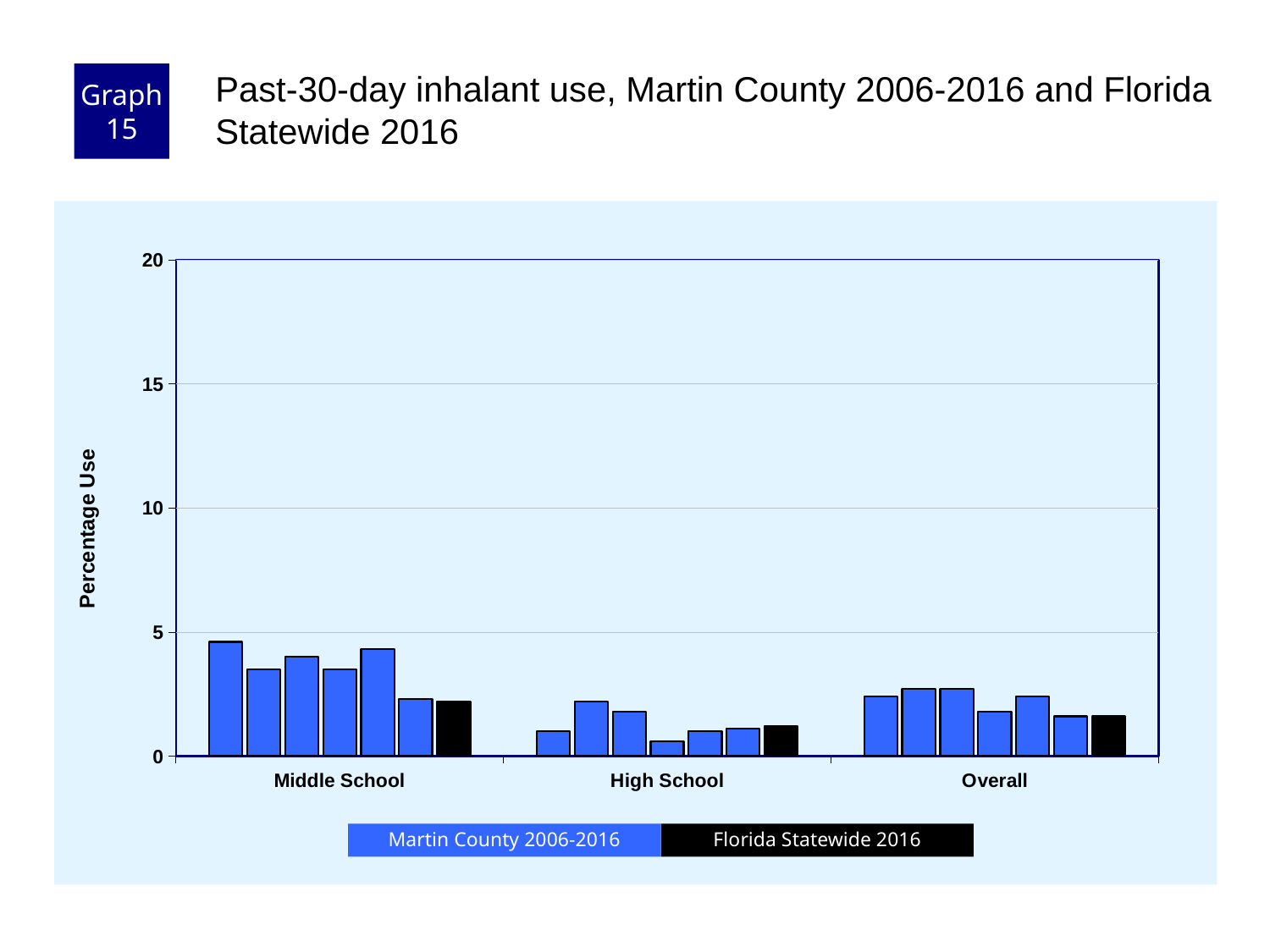
Which school-level group has the tallest bar in the chart? Middle School Which is larger: the Florida Statewide 2016 value for Middle School or for Overall? Middle School Which is larger: the Florida Statewide 2016 value for Middle School or for High School? Middle School Which school-level group has the shortest bar in the chart? High School How many series does the legend list? 2 What is the label on the y axis? Percentage Use Is the highest Martin County bar in the Middle School group greater or less than 5? less Which colour represents Florida Statewide 2016 in the legend? black What kind of chart is shown on the slide? bar chart Is the value for Florida Statewide 2016 in the Middle School group greater or less than 5? less How many school-level categories are shown on the x axis? 3 Is the Florida Statewide 2016 value for High School greater or less than 5? less